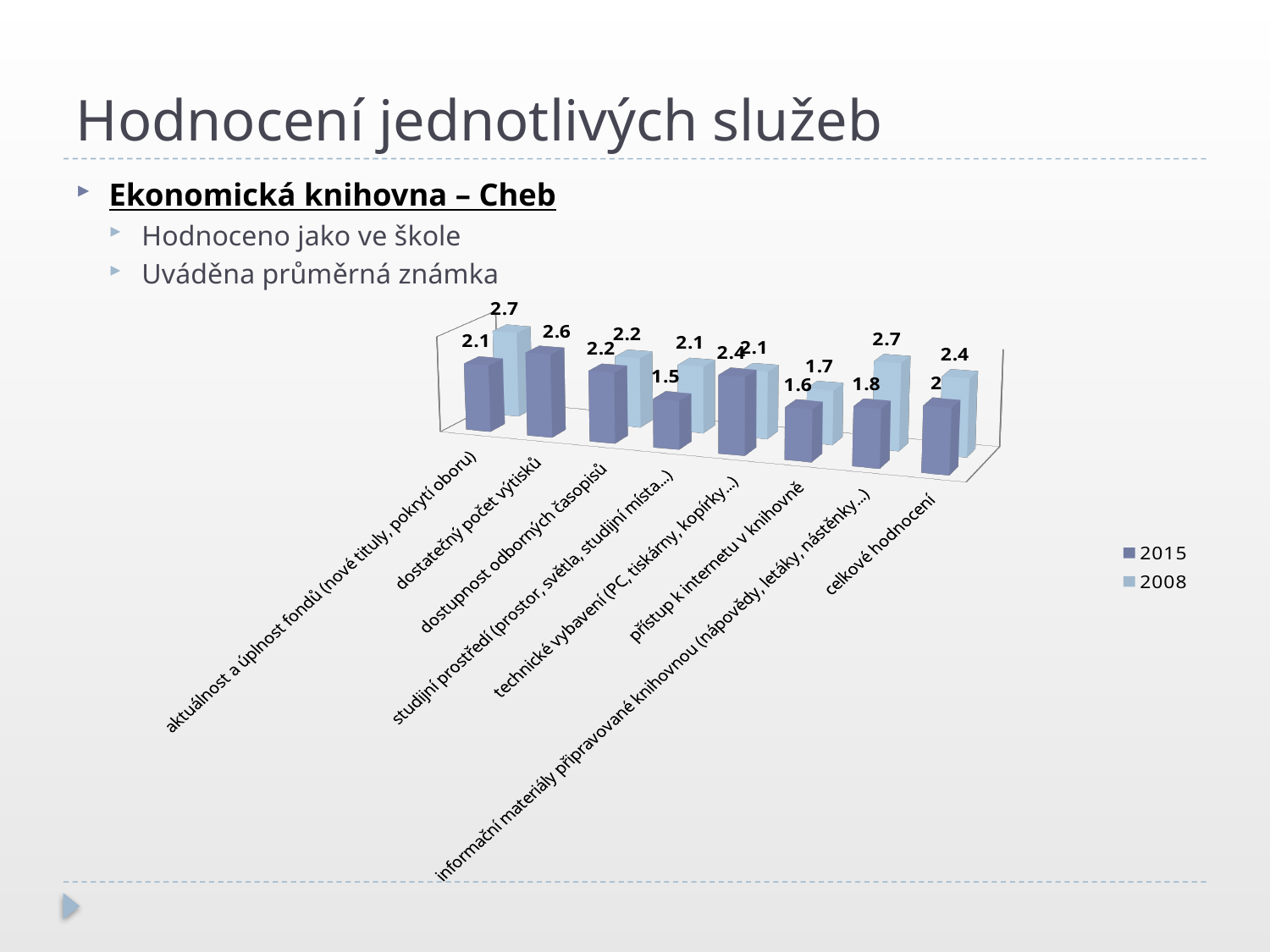
Which category has the lowest 2015 value? studijní prostředí (prostor, světla, studijní místa...) How many categories are shown on the chart's x axis? 8 What is the 2008 value for 'aktuálnost a úplnost fondů (nové tituly, pokrytí oboru)'? 2.7 What is the 2015 value for 'aktuálnost a úplnost fondů (nové tituly, pokrytí oboru)'? 2.1 What is the difference between the 2008 and 2015 values for 'celkové hodnocení'? 0.4 What is the 2008 value for 'celkové hodnocení'? 2.4 How many series does the legend list? 2 For 'technické vybavení (PC, tiskárny, kopírky...)', which year has the higher value, 2015 or 2008? 2015 What kind of chart is shown on the slide? Bar chart What is the 2015 value for 'celkové hodnocení'? 2 What is the 2015 value for 'studijní prostředí (prostor, světla, studijní místa...)'? 1.5 What is the 2008 value for 'informační materiály připravované knihovnou (nápovědy, letáky, nástěnky...)'? 2.7